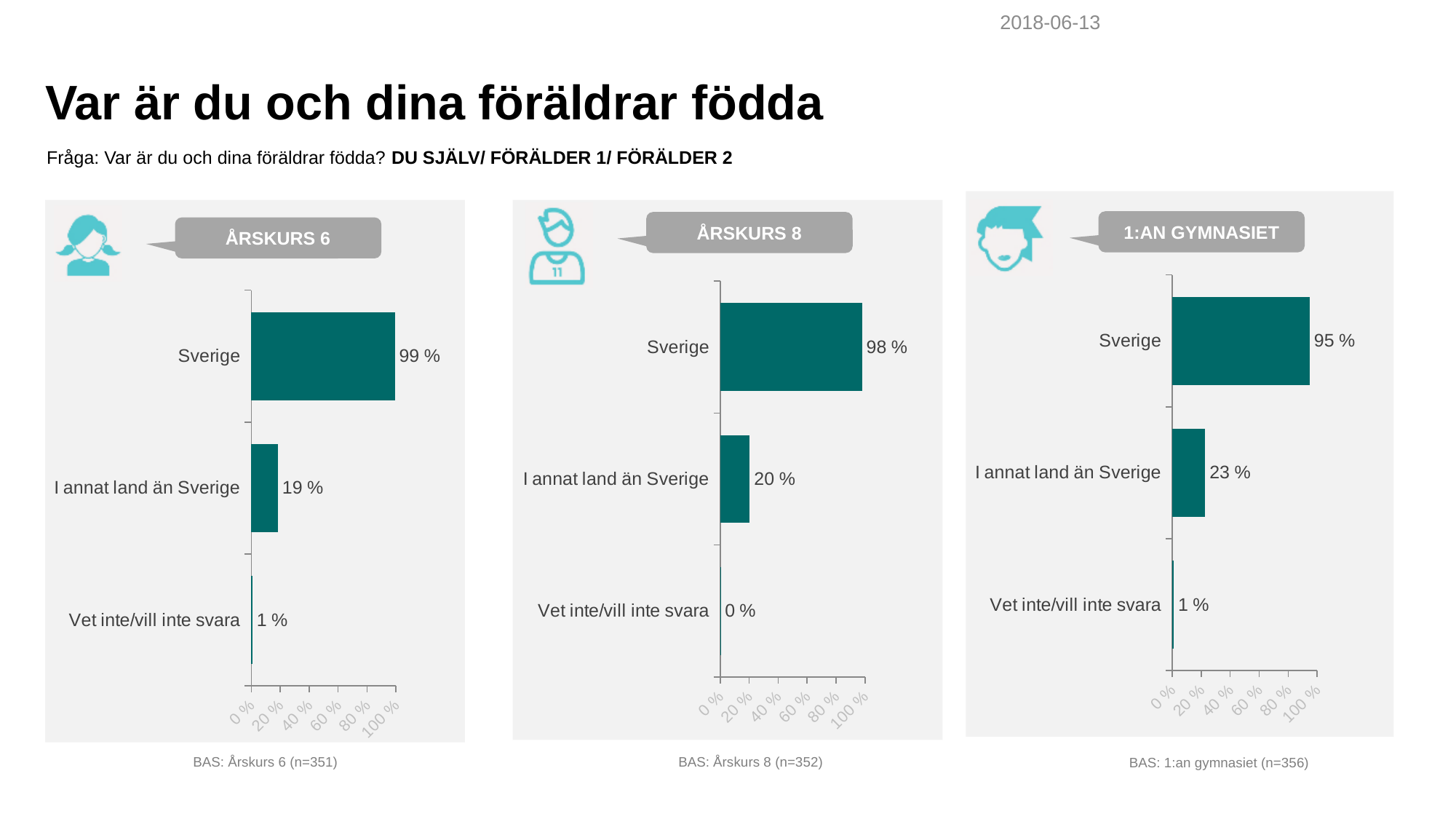
In the 1:AN GYMNASIET chart, which category has the highest value? Sverige How many charts are on the slide? 3 How many categories does the ÅRSKURS 8 chart show? 3 What is the base (n) stated below the ÅRSKURS 8 chart? n=352 In the 1:AN GYMNASIET chart, what is the value for Vet inte/vill inte svara? 1 % Is the value for I annat land än Sverige larger in the ÅRSKURS 6 chart or in the 1:AN GYMNASIET chart? 1:AN GYMNASIET In the ÅRSKURS 8 chart, what is the value for I annat land än Sverige? 20 % In the 1:AN GYMNASIET chart, what is the difference between the values for Sverige and I annat land än Sverige? 72 % What kind of chart is the ÅRSKURS 6 chart? bar chart In the ÅRSKURS 8 chart, which category has the lowest value? Vet inte/vill inte svara In the ÅRSKURS 6 chart, what is the value for Sverige? 99 % In the ÅRSKURS 6 chart, is the value for I annat land än Sverige greater or less than 40 %? less